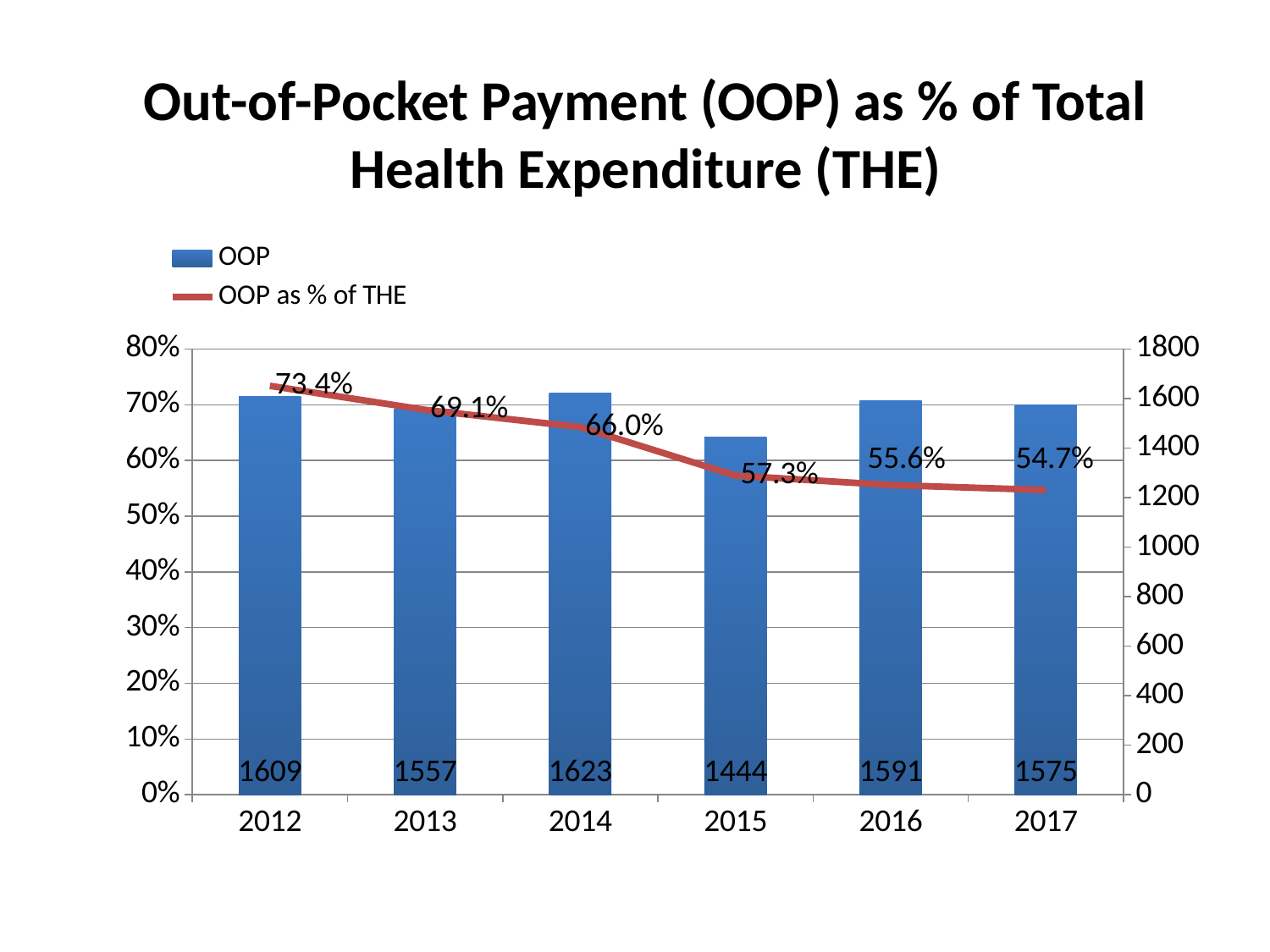
How many years are shown on the x axis? 6 How many series does the legend list? 2 Which year has the highest OOP value? 2014 Which year has the lowest OOP value? 2015 What is the difference between OOP as % of THE in 2012 and 2017? 18.7% What is OOP as % of THE in 2015? 57.3% Does OOP as % of THE rise or fall from 2012 to 2017? fall Which year has the lowest OOP as % of THE? 2017 What is the OOP value for 2017? 1575 What is the difference between the OOP values for 2014 and 2015? 179 Which year has a larger OOP value, 2012 or 2016? 2012 What is the OOP value for 2014? 1623